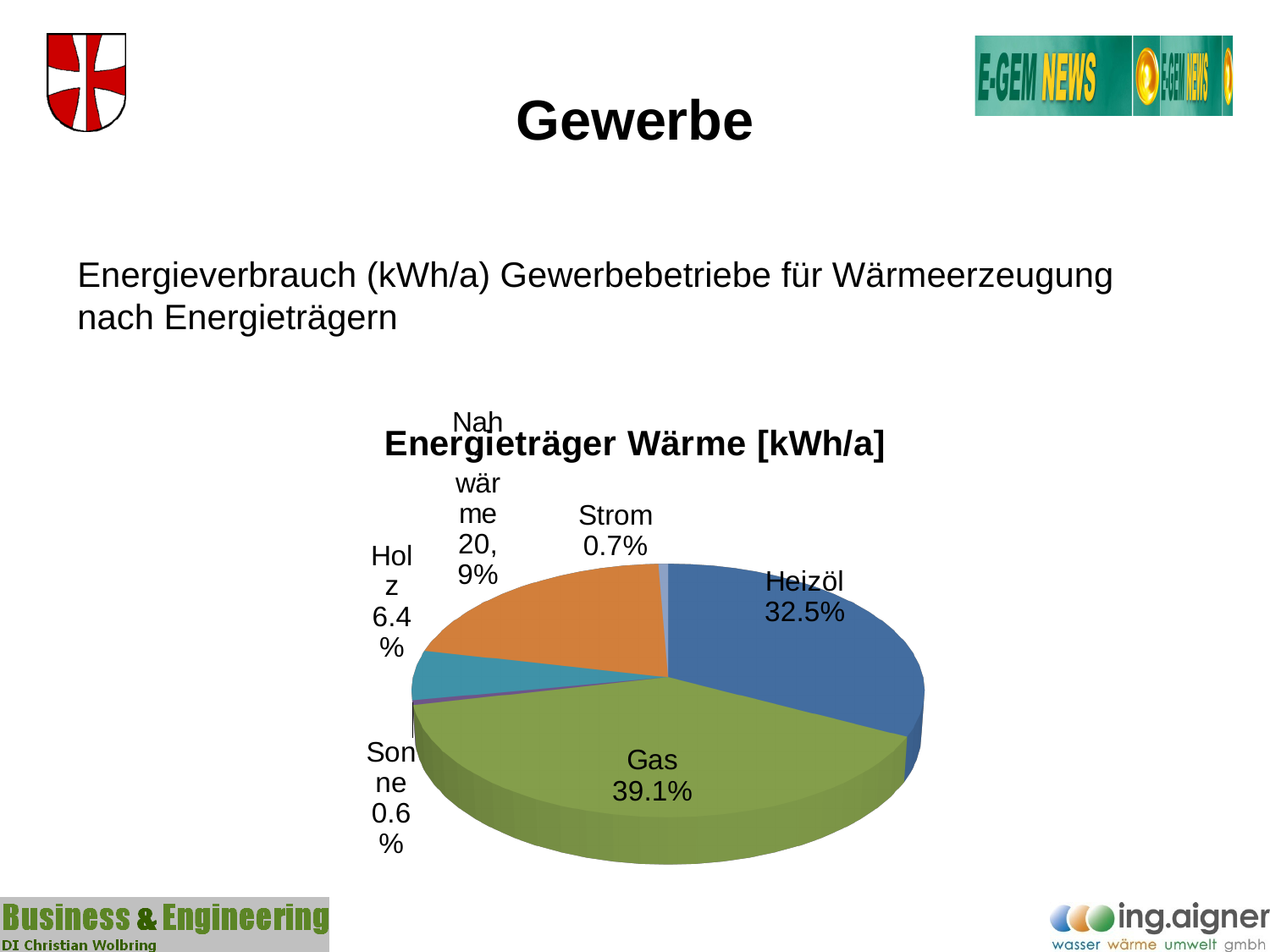
What kind of chart is shown on the slide? pie chart What share of the pie does Gas have? 39.1% How many slices does the pie chart have? 6 What share of the pie does Holz have? 6.4% What is the title of the chart? Energieträger Wärme [kWh/a] What share of the pie does Heizöl have? 32.5% Which energy source has the smallest share of the pie? Sonne Which energy source has the largest share of the pie? Gas Which has a larger share, Heizöl or Nahwärme? Heizöl